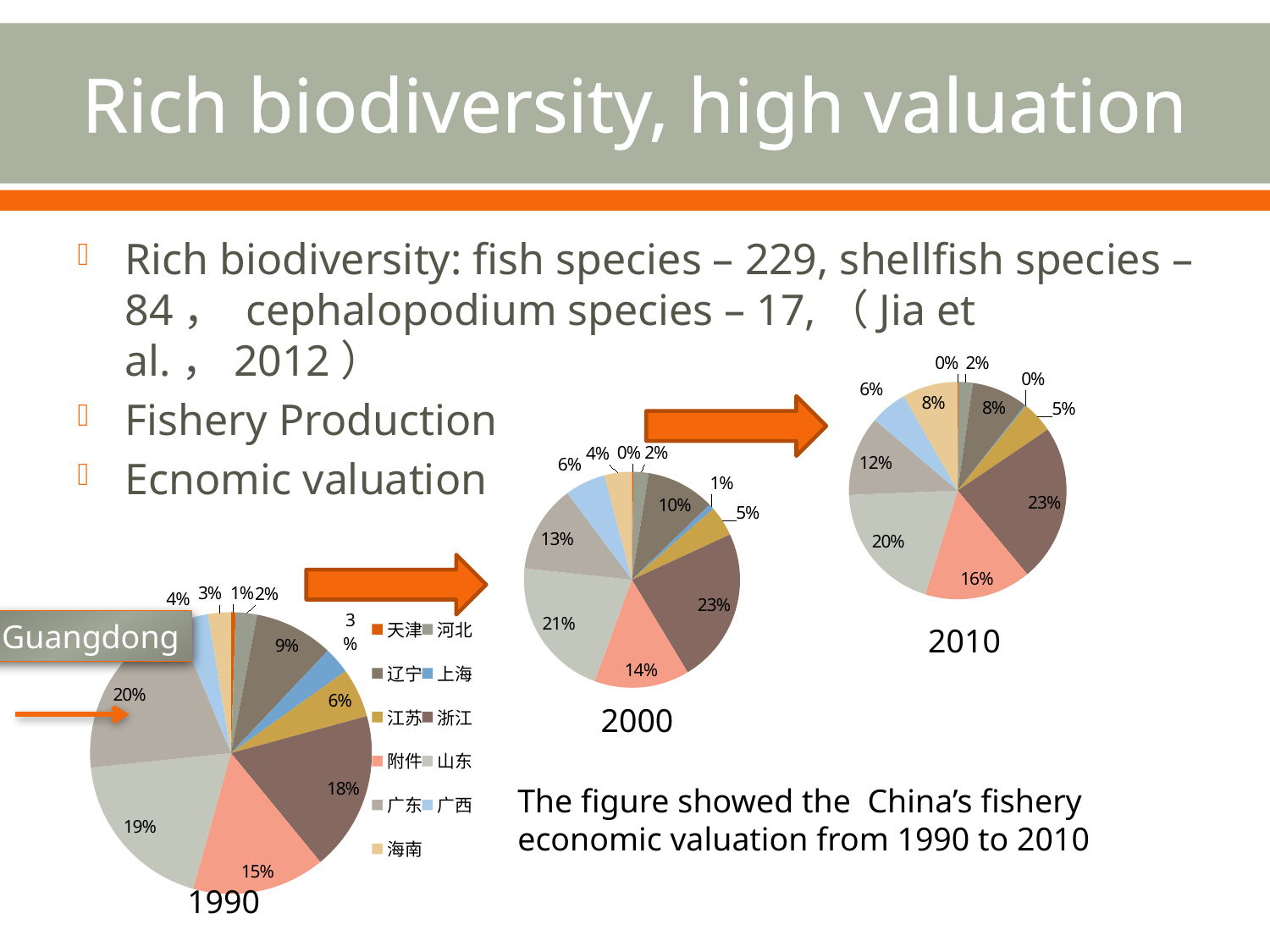
According to the caption, what do the pie charts show? China's fishery economic valuation from 1990 to 2010 What kind of charts are shown on the slide? Pie charts How many pie charts are on the slide? 3 In the 2010 pie chart, how many slices are labeled 0%? 2 In the 1990 pie chart, what is the largest labeled share? 20% How many entries does the legend list? 11 In the 2000 pie chart, what is the smallest labeled share? 0% In the 2010 pie chart, what is the largest labeled share? 23% In the 2000 pie chart, what is the largest labeled share? 23% In the 1990 pie chart, what is the smallest labeled share? 1% Which years are the three pie charts labeled with? 1990, 2000, 2010 In the 1990 pie chart, what share is shown for Guangdong? 20%